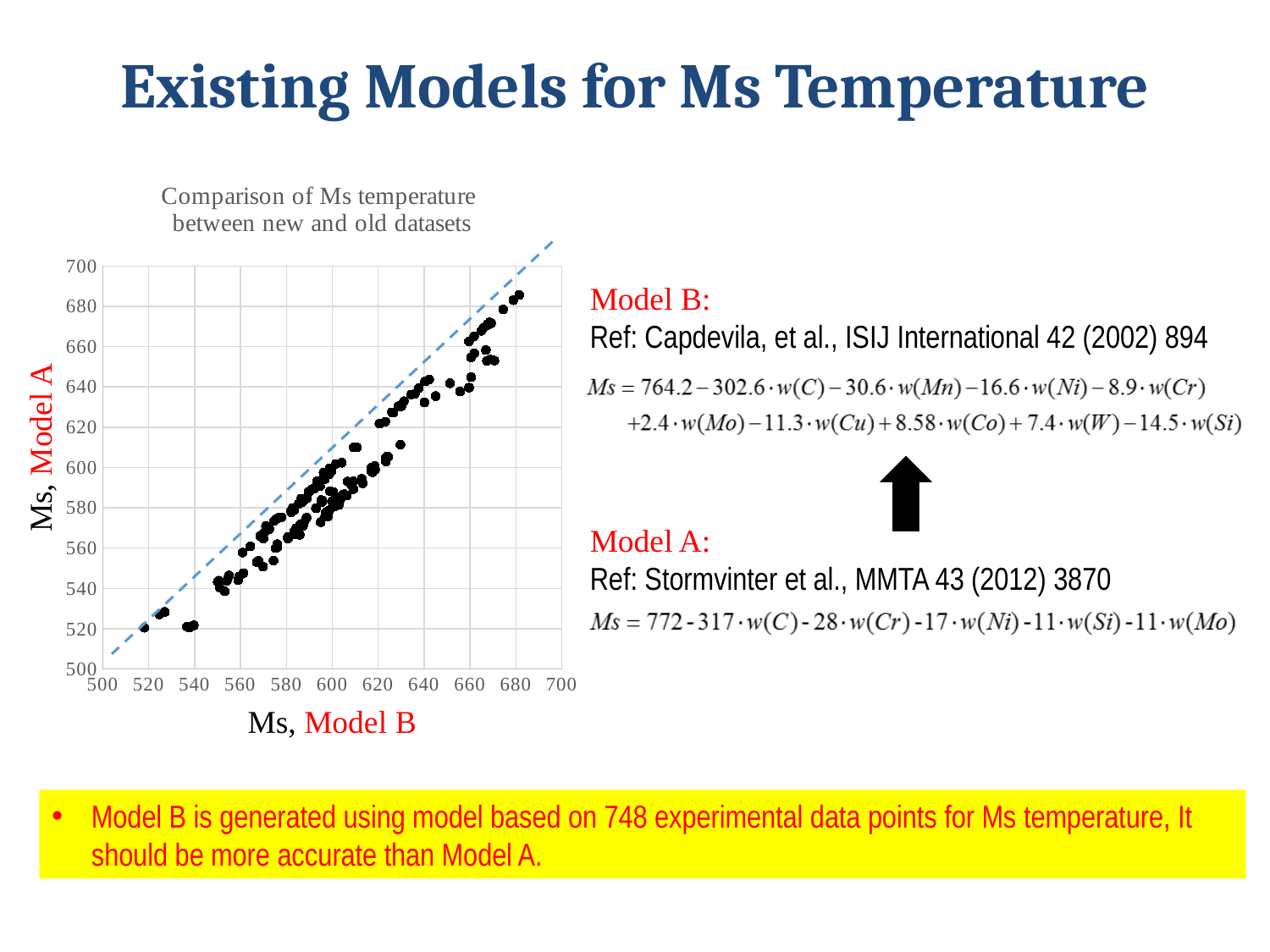
What is the title of the chart? Comparison of Ms temperature between new and old datasets Is the lowest plotted Model A Ms value greater or less than 540? less What is the label of the x axis of the chart? Ms, Model B Is the highest plotted Model B Ms value greater or less than 700? less Is the highest plotted Model A Ms value greater or less than 660? greater Do the plotted points lie mostly above or below the dashed line? below What kind of chart is shown on the slide? scatter chart As the Model B Ms values increase along the x axis, do the plotted Model A Ms values rise or fall? rise